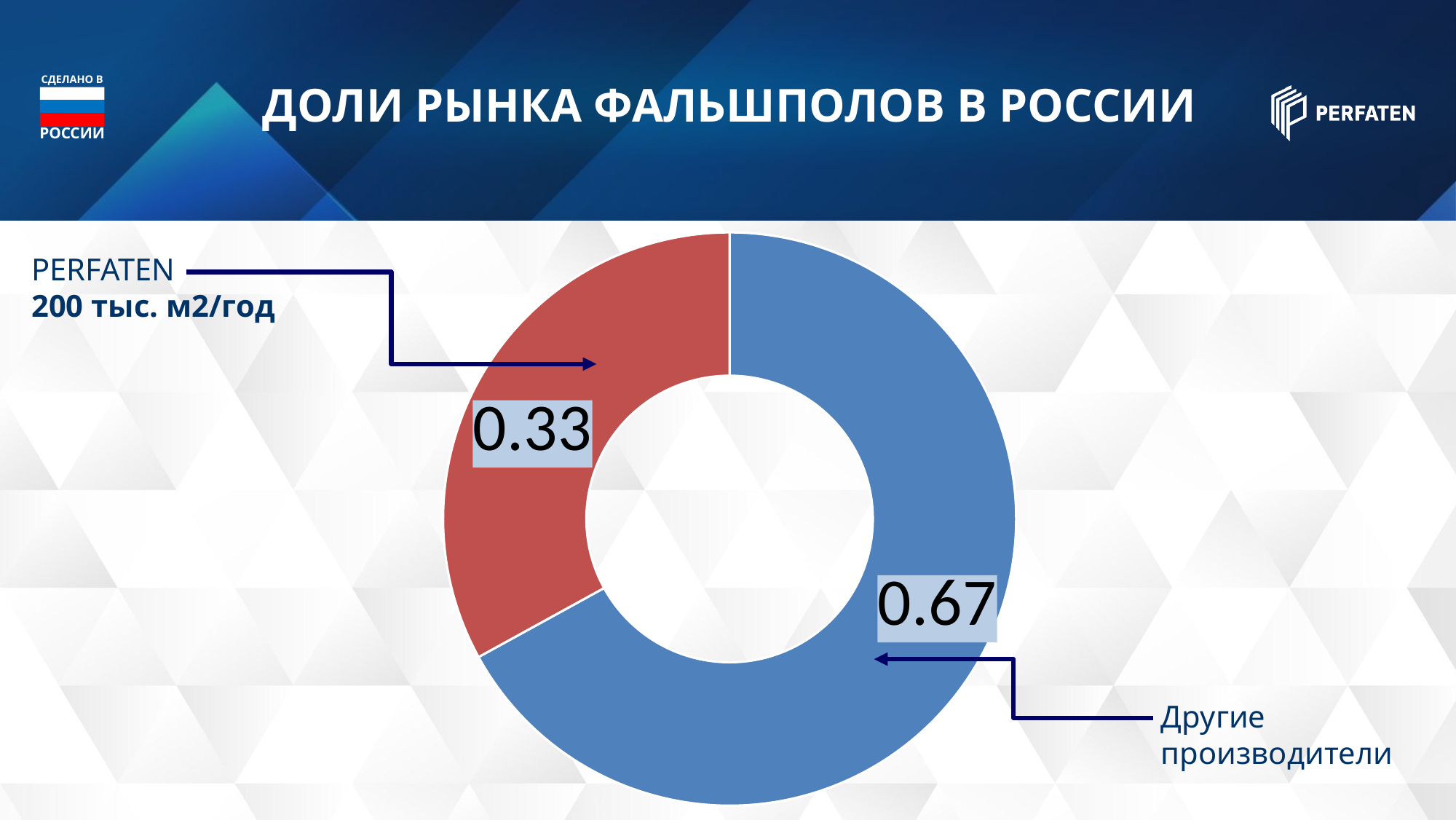
What is the title of the slide? ДОЛИ РЫНКА ФАЛЬШПОЛОВ В РОССИИ Which is larger: the value for PERFATEN or the value for Другие производители? Другие производители What annual volume is stated for PERFATEN next to the chart? 200 тыс. м2/год What colour is the PERFATEN segment of the chart? Red What kind of chart is shown on the slide? Doughnut chart What value is shown for the Другие производители segment of the chart? 0.67 How many segments does the chart have? 2 What value is shown for the PERFATEN segment of the chart? 0.33 What is the difference between the values for Другие производители and PERFATEN? 0.34 Which segment of the chart has the smallest value? PERFATEN Which segment of the chart has the largest value? Другие производители